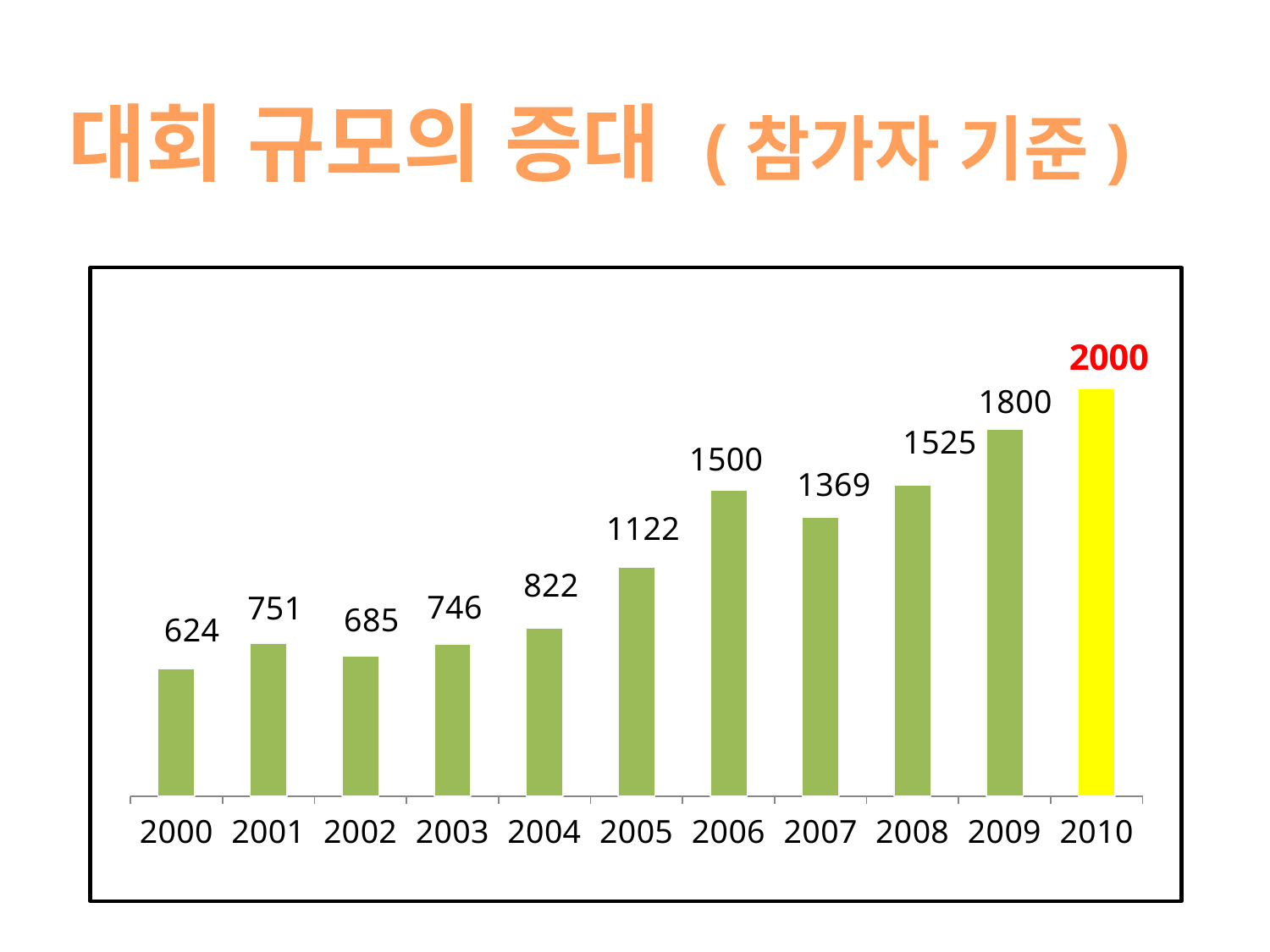
What is the value for 2006? 1500 Do the values generally rise or fall from 2000 to 2010? Rise Which year has the highest value? 2010 How many years are shown on the x axis? 11 What is the difference between the values for 2001 and 2002? 66 Which is larger, the value for 2006 or the value for 2007? 2006 What is the value for 2000? 624 What is the value for 2010? 2000 Which bar is coloured differently from the others? 2010 What is the difference between the values for 2009 and 2008? 275 What kind of chart is shown on the slide? Bar chart Which year has the lowest value? 2000